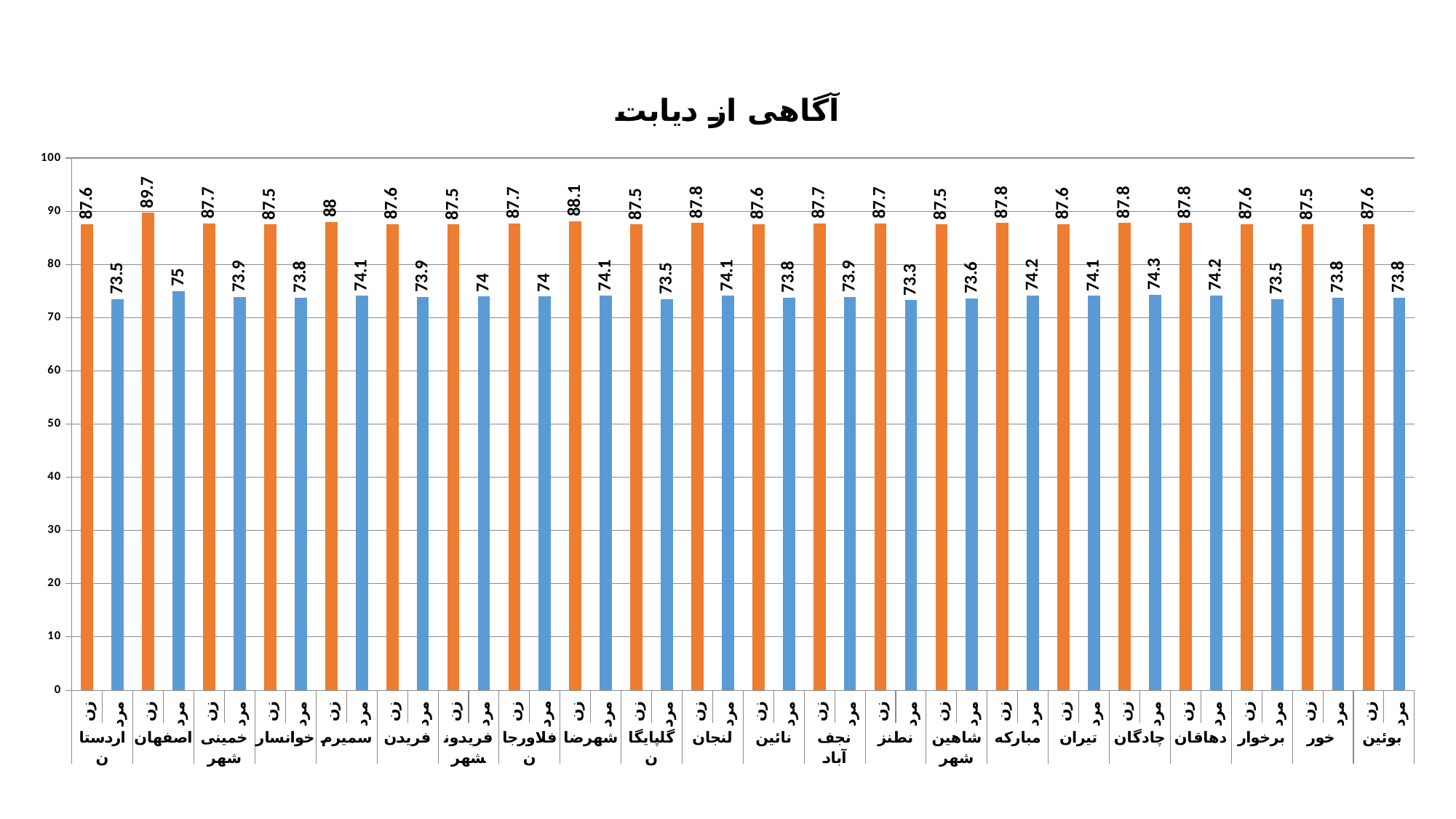
How many cities are shown on the x axis? 22 What kind of chart is shown on the slide? bar chart What is the difference between the زن (women) and مرد (men) values in اصفهان? 14.7 Is the value for مرد (men) in بوئین greater or less than 80? less Which city has the highest value for زن (women)? اصفهان What is the difference between the زن (women) and مرد (men) values in سمیرم? 13.9 What is the value for زن (women) in اصفهان? 89.7 Which city has the lowest value for مرد (men)? نطنز What is the value for مرد (men) in نطنز? 73.3 What is the value for مرد (men) in چادگان? 74.3 Which is larger in اردستان: the value for زن (women) or for مرد (men)? زن (women) What is the value for زن (women) in شهرضا? 88.1